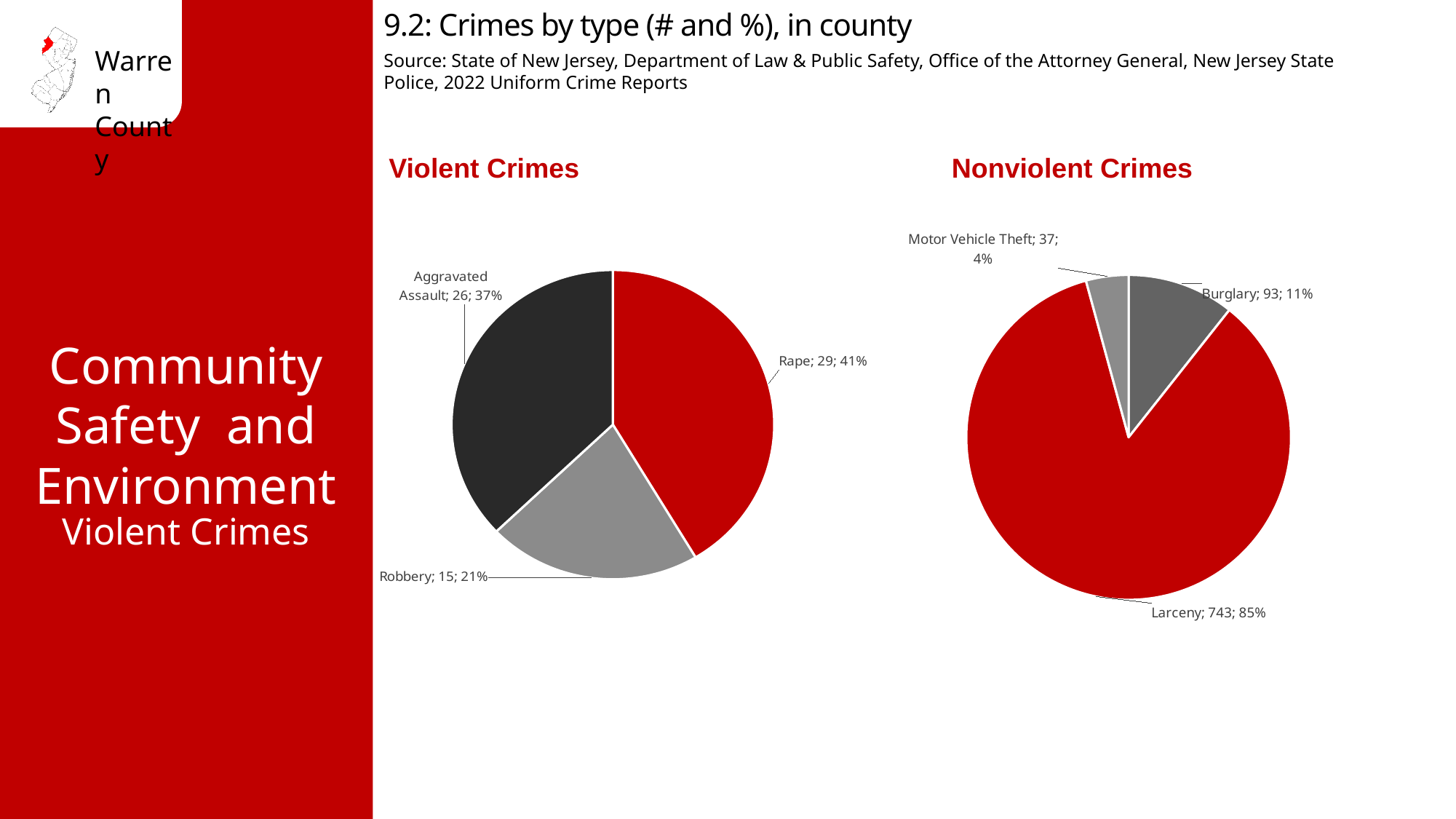
In the Violent Crimes chart, what is the difference between the Rape count and the Robbery count? 14 In the Violent Crimes chart, how many rapes are shown? 29 In the Nonviolent Crimes chart, how many larcenies are shown? 743 In the Nonviolent Crimes chart, which is larger, Burglary or Motor Vehicle Theft? Burglary In the Violent Crimes chart, what share of the pie is Aggravated Assault? 37% In the Violent Crimes chart, how many categories are shown? 3 In the Violent Crimes chart, which category has the lowest count? Robbery What type of chart is the Nonviolent Crimes chart? Pie chart In the Nonviolent Crimes chart, what is the difference between the Burglary count and the Motor Vehicle Theft count? 56 In the Violent Crimes chart, which category has the highest count? Rape In the Nonviolent Crimes chart, what share of the pie is Burglary? 11% In the Nonviolent Crimes chart, which category has the lowest count? Motor Vehicle Theft